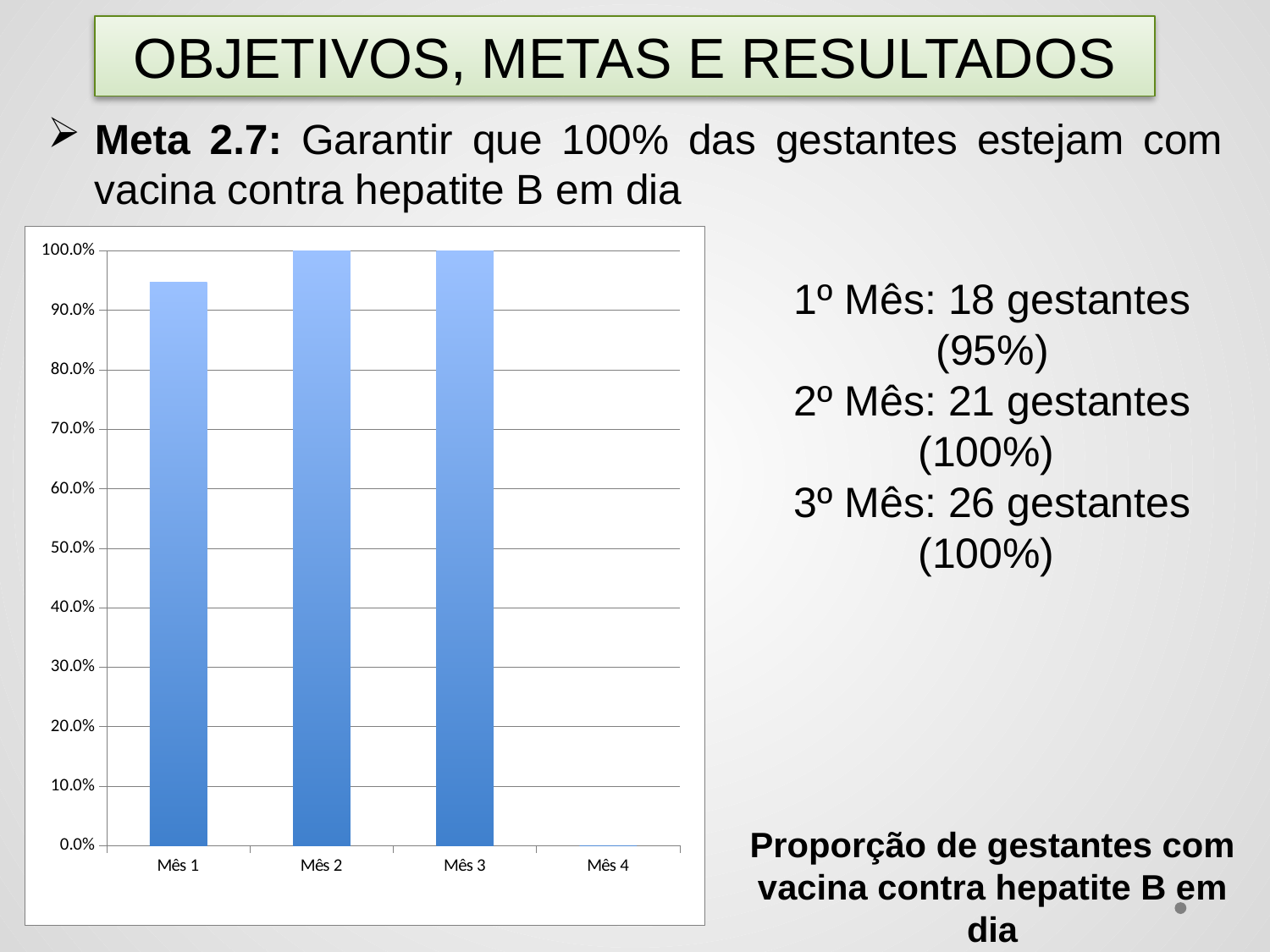
What is the value for Mês 2 in the chart? 100.0% What is the highest value shown on the chart's y axis? 100.0% Which category on the x axis has no bar plotted? Mês 4 How many categories are shown on the x axis of the chart? 4 What is the difference between the values for Mês 2 and Mês 3? 0.0% Is the value for Mês 1 greater or less than 100.0%? less What kind of chart is shown on the slide? bar chart What is the value for Mês 3 in the chart? 100.0% Among the months with a plotted bar, which has the lowest value? Mês 1 Which is larger, the value for Mês 1 or the value for Mês 2? Mês 2 Do the values rise or fall from Mês 1 to Mês 3? rise Is the value for Mês 1 greater or less than 90.0%? greater